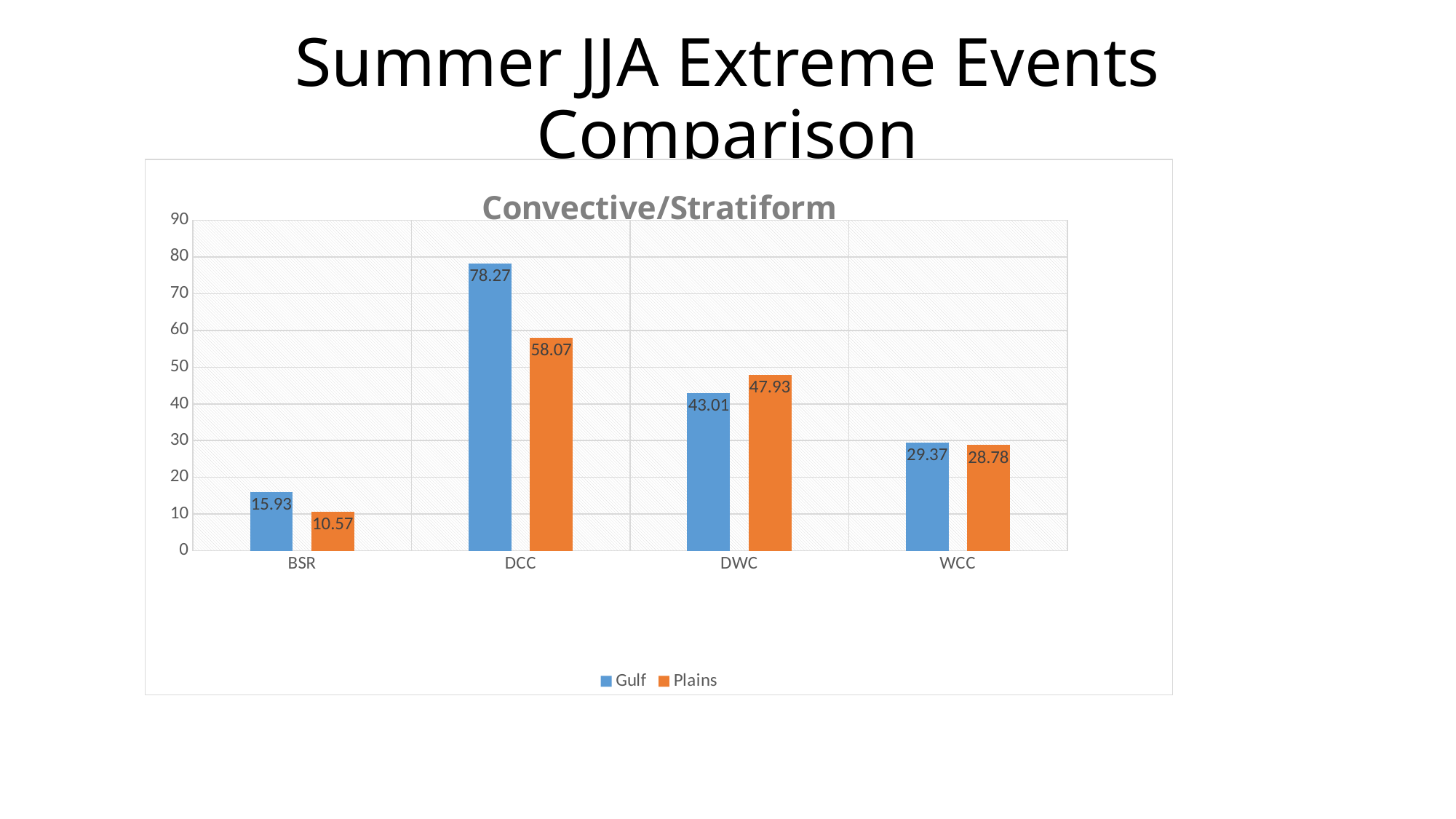
What is the difference between the Gulf and Plains values for DCC? 20.2 How many categories are shown on the x axis? 4 How many series does the legend list? 2 What kind of chart is shown? Bar chart What is the Gulf value for WCC? 29.37 Which category has the highest Gulf value? DCC For DWC, which series has the larger value, Gulf or Plains? Plains What is the Plains value for BSR? 10.57 What is the Plains value for DWC? 47.93 What is the Gulf value for DCC? 78.27 Which category has the lowest Plains value? BSR What is the title of the chart? Convective/Stratiform